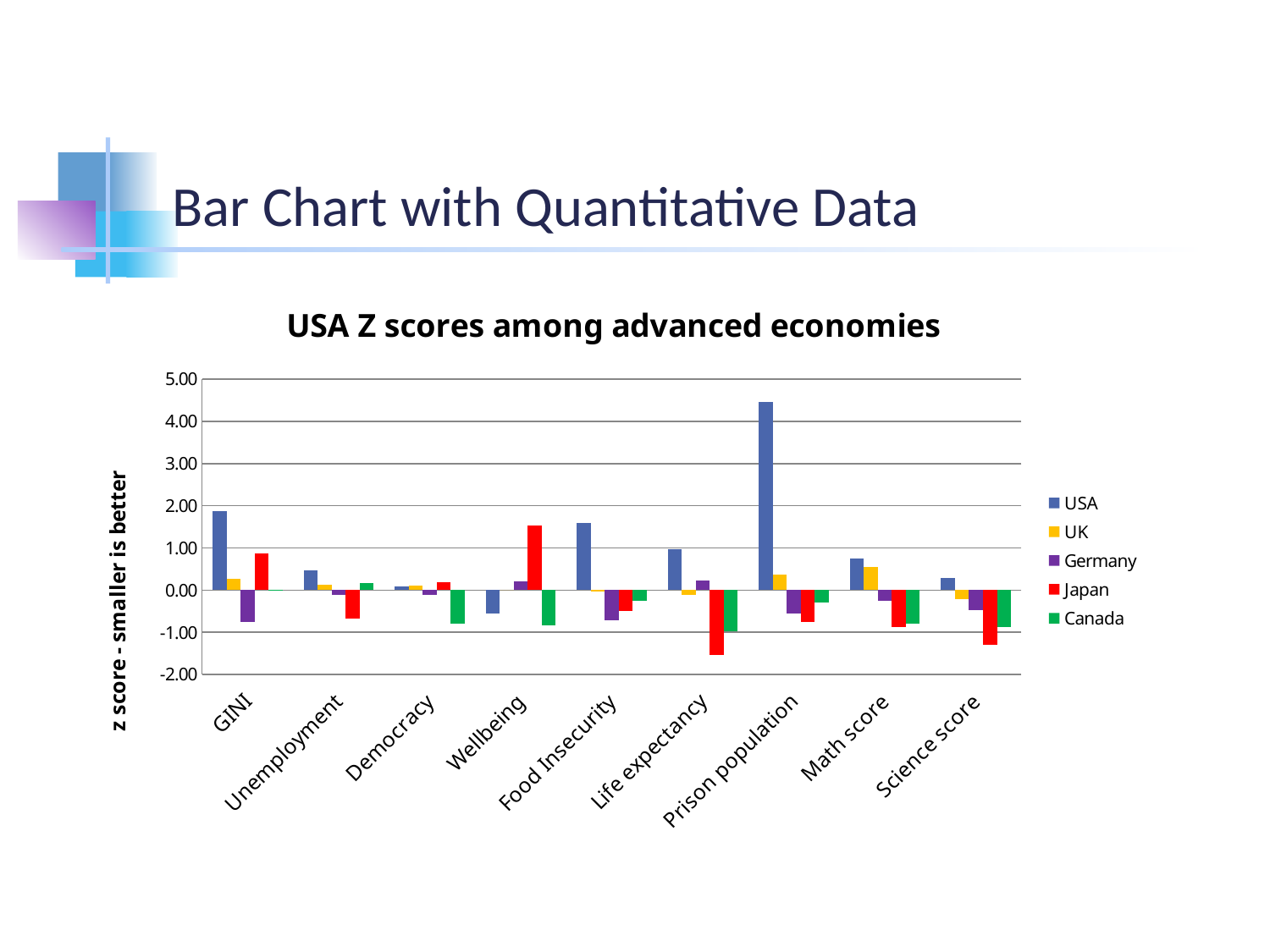
For which category is the USA bar the highest? Prison population How many series does the legend list? 5 Is the USA value for Prison population greater or less than 4.00? greater How many categories are shown along the x axis? 9 What kind of chart is shown on the slide? Bar chart For Wellbeing, which is larger: the Japan value or the USA value? Japan Is the Japan value for Wellbeing greater or less than 1.00? greater For which category is the Japan bar the lowest? Life expectancy Is the USA value for GINI greater or less than 1.00? greater What is the title of the chart? USA Z scores among advanced economies What is the label on the vertical axis? z score - smaller is better For GINI, which is larger: the USA value or the Japan value? USA